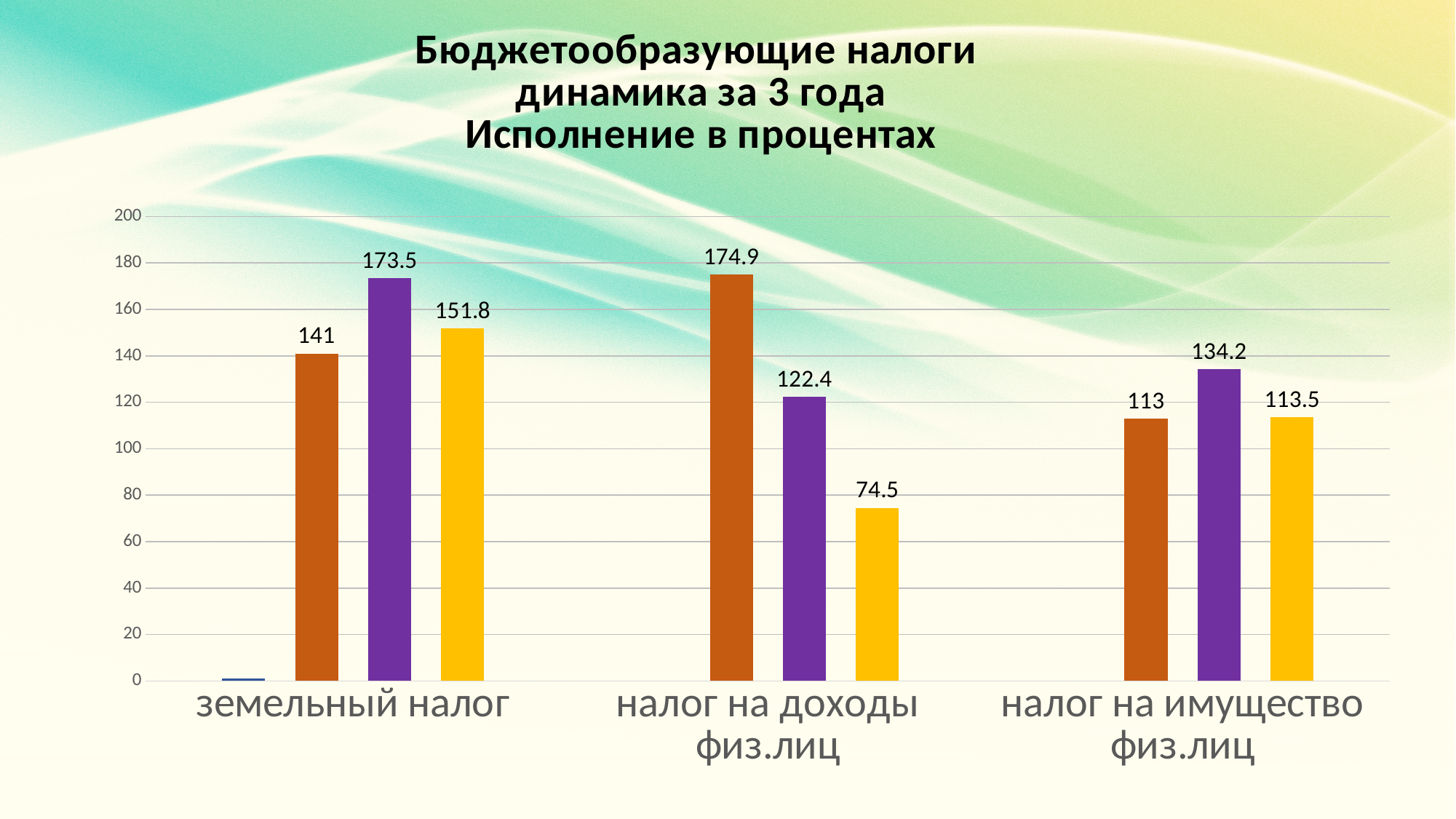
What is the value of the purple bar for налог на имущество физ.лиц? 134.2 What is the title of the chart? Бюджетообразующие налоги динамика за 3 года Исполнение в процентах Which is larger for налог на имущество физ.лиц: the orange bar or the purple bar? the purple bar Which category has the highest orange bar? налог на доходы физ.лиц What type of chart is shown on the slide? bar chart How many categories are shown on the x axis? 3 What is the value of the yellow bar for налог на доходы физ.лиц? 74.5 Which category has the lowest yellow bar? налог на доходы физ.лиц What is the value of the orange bar for земельный налог? 141 What is the value of the purple bar for земельный налог? 173.5 What is the difference between the purple bar and the yellow bar for налог на доходы физ.лиц? 47.9 What is the difference between the orange bar for налог на доходы физ.лиц and the orange bar for земельный налог? 33.9